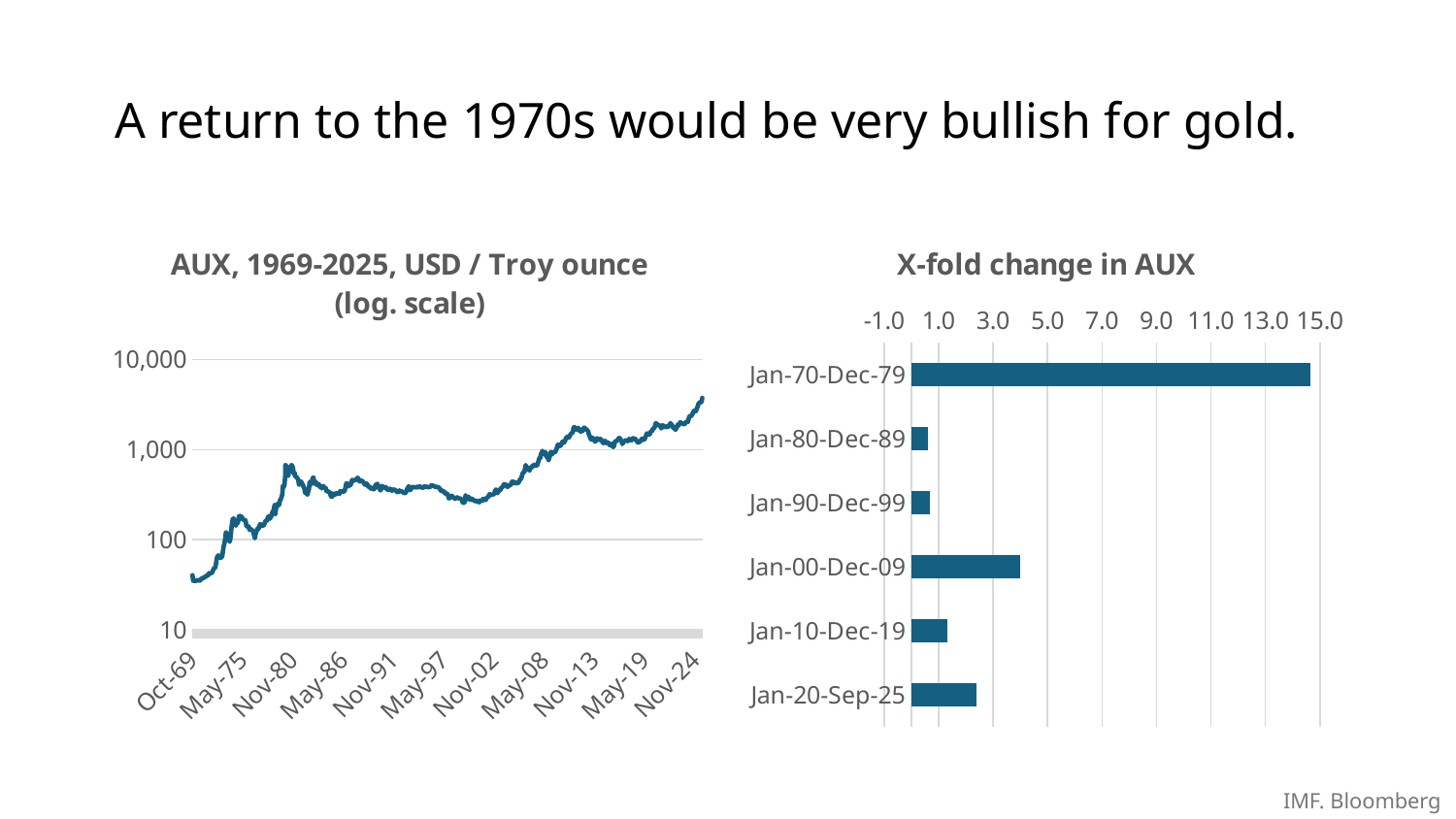
What kind of chart is the 'X-fold change in AUX' chart? bar chart In the 'X-fold change in AUX' chart, which is larger: the value for Jan-00-Dec-09 or the value for Jan-20-Sep-25? Jan-00-Dec-09 In the 'AUX, 1969-2025, USD / Troy ounce (log. scale)' chart, does the gold price overall rise or fall from Oct-69 to Nov-24? rise In the 'X-fold change in AUX' chart, is the value for Jan-70-Dec-79 greater or less than 13.0? greater How many periods are shown in the 'X-fold change in AUX' chart? 6 In the 'X-fold change in AUX' chart, is the value for Jan-00-Dec-09 greater or less than 3.0? greater In the 'X-fold change in AUX' chart, which period has the highest value? Jan-70-Dec-79 In the 'X-fold change in AUX' chart, is the value for Jan-20-Sep-25 greater or less than 3.0? less What is the title of the chart on the right of the slide? X-fold change in AUX What kind of chart is the 'AUX, 1969-2025, USD / Troy ounce (log. scale)' chart? line chart